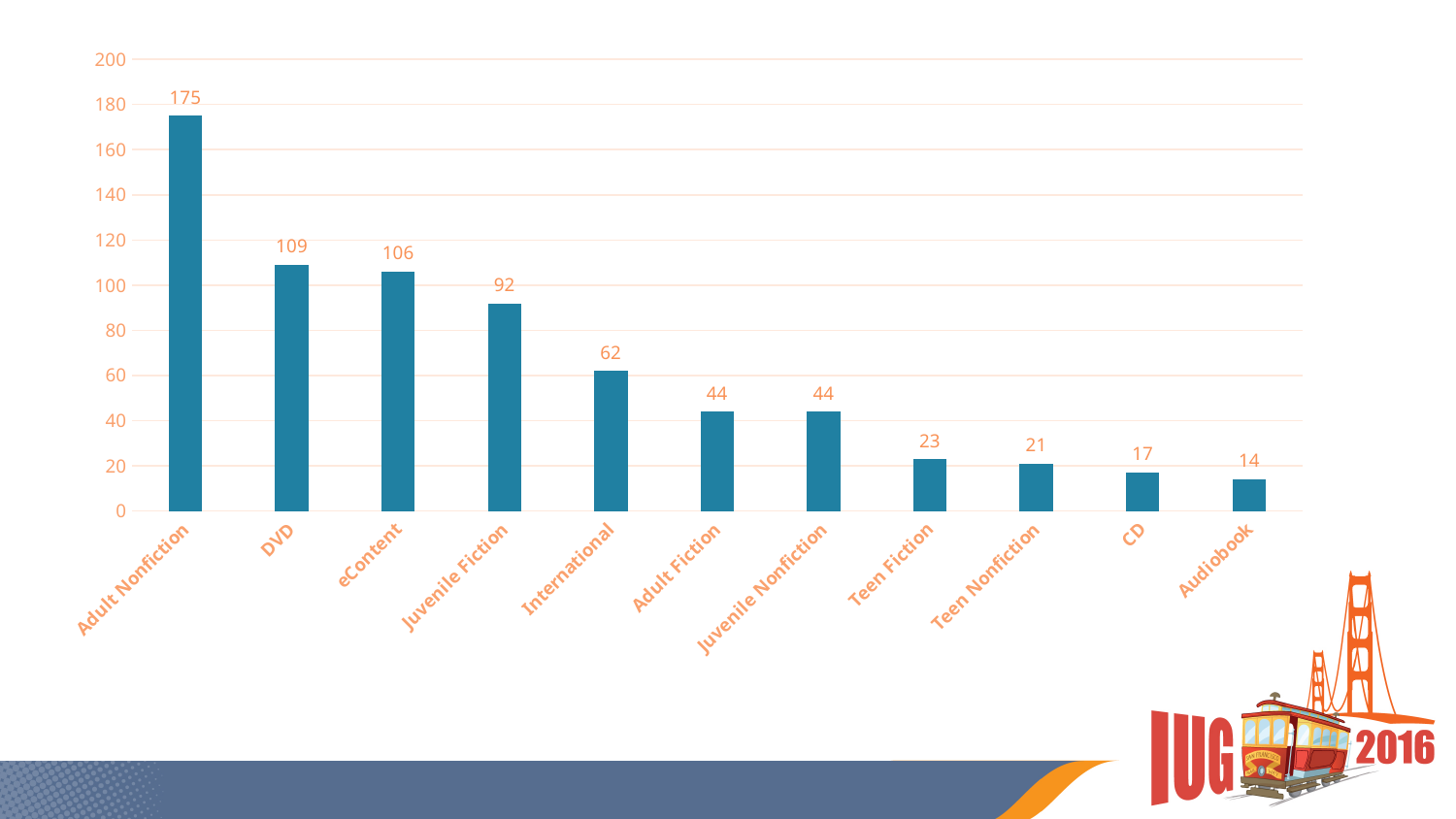
What is the value for Adult Nonfiction? 175 What kind of chart is shown on the slide? bar chart Is the value for International greater or less than 80? less Which category has the highest value? Adult Nonfiction Which is larger, the value for Teen Fiction or the value for CD? Teen Fiction Do the values rise or fall from left to right along the x axis? fall What is the value for Juvenile Fiction? 92 How many categories are shown on the x axis? 11 Which category has the lowest value? Audiobook What is the value for Teen Nonfiction? 21 What is the difference between the values for DVD and eContent? 3 What is the difference between the values for Adult Nonfiction and International? 113